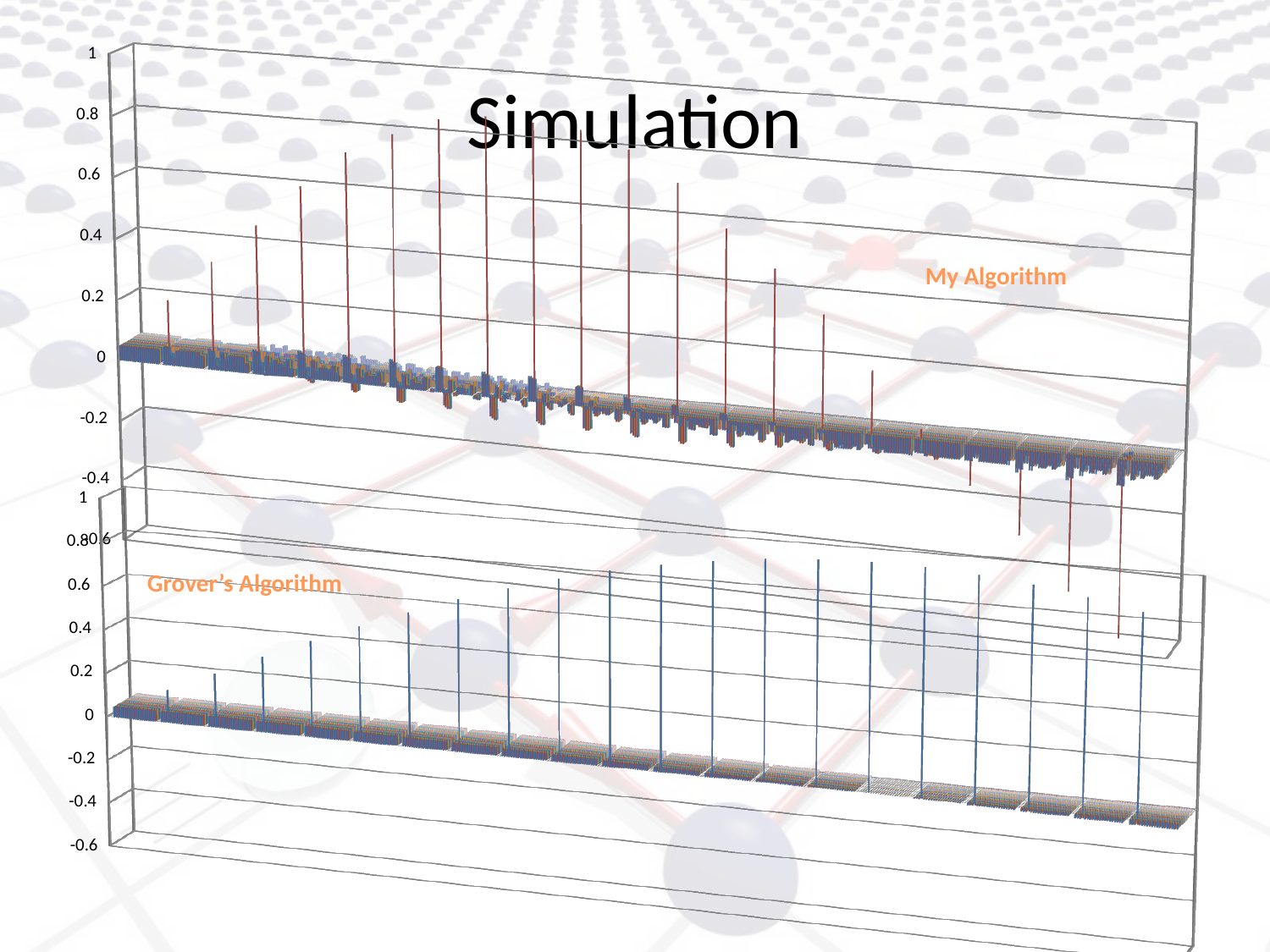
What kind of chart is the top chart labeled "My Algorithm"? bar chart In the top chart ("My Algorithm"), are the tallest spikes greater or less than 0.4? greater How many charts are shown on the slide? 2 In the top chart ("My Algorithm"), do any bars extend below 0 on the vertical axis? yes What is the label of the bottom chart on the slide? Grover's Algorithm What kind of chart is the bottom chart labeled "Grover's Algorithm"? bar chart In the bottom chart ("Grover's Algorithm"), are the tallest spikes greater or less than 0.4? greater In the top chart ("My Algorithm"), what is the highest value shown on the vertical axis? 1